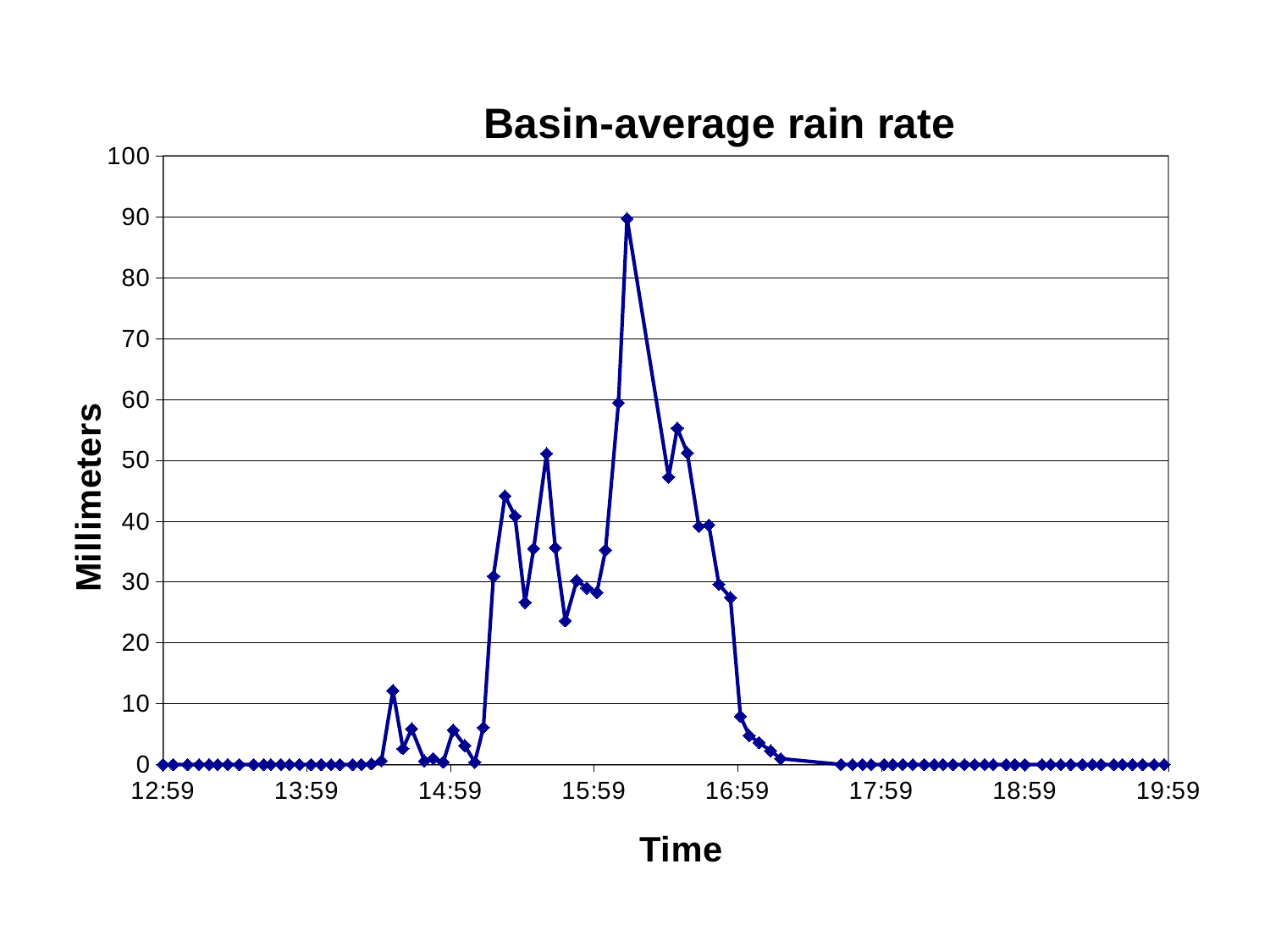
Does the value rise or fall from the peak of the chart to 16:59? fall How many time labels are shown on the x axis? 8 Is the value at 14:59 greater or less than 10? less What is the label of the y axis? Millimeters Does the value rise or fall between 15:59 and the peak of the chart? rise What is the value at 12:59? 0 What is the title of the chart? Basin-average rain rate What is the value at 17:59? 0 What is the value at 19:59? 0 What kind of chart is shown on the slide? line chart Is the highest value on the chart greater or less than 80? greater